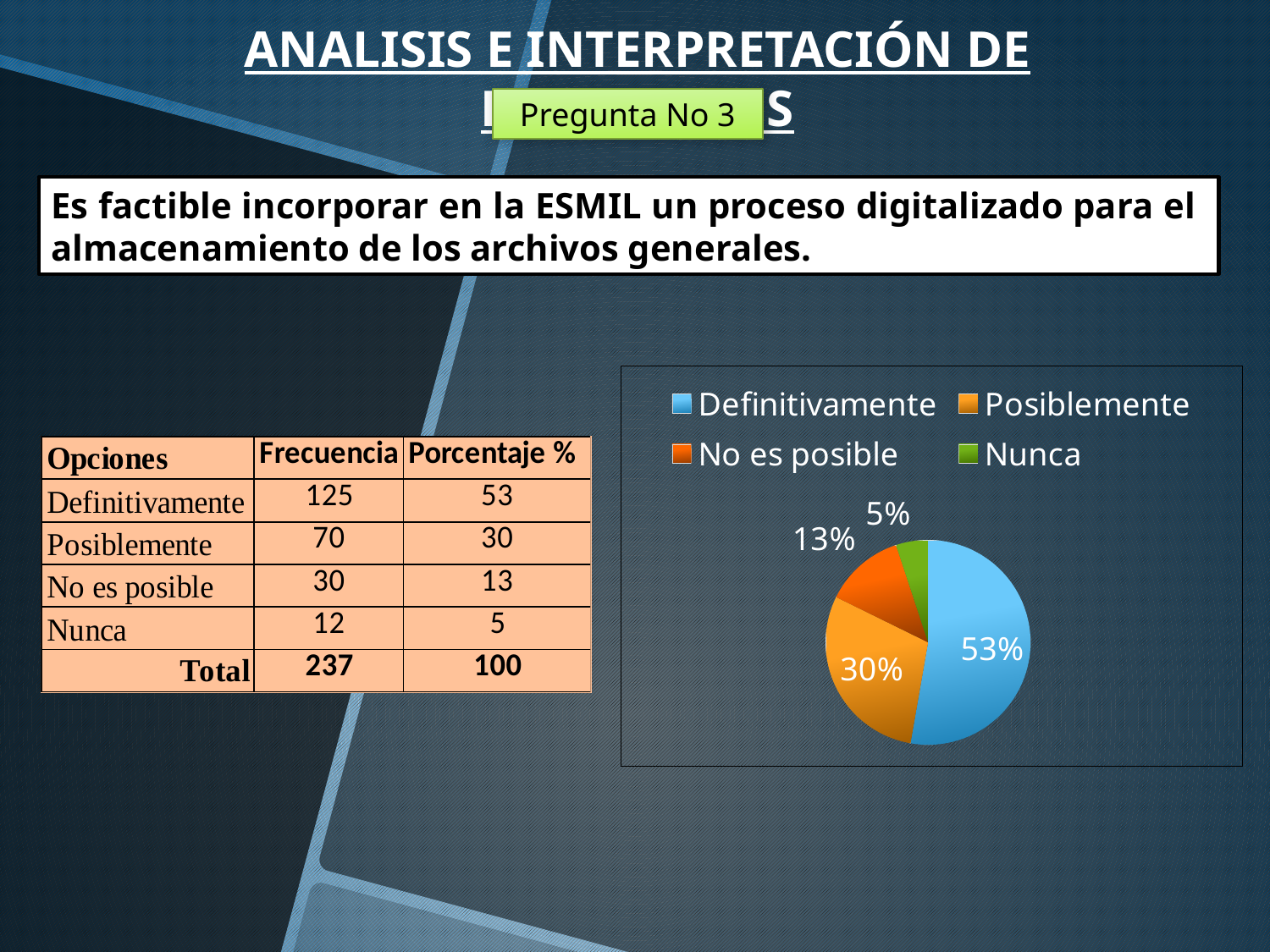
What percentage does the pie chart show for Nunca? 5% Which slice is larger, No es posible or Nunca? No es posible What percentage does the pie chart show for No es posible? 13% What colour is the Definitivamente slice in the pie chart? blue What colour is the Nunca slice in the pie chart? green Which category has the smallest slice in the pie chart? Nunca What percentage does the pie chart show for Posiblemente? 30% What kind of chart is shown on the slide? pie chart What percentage does the pie chart show for Definitivamente? 53% What is the difference in percentage points between the Definitivamente and Posiblemente slices? 23 How many categories does the pie chart legend list? 4 Which category has the largest slice in the pie chart? Definitivamente